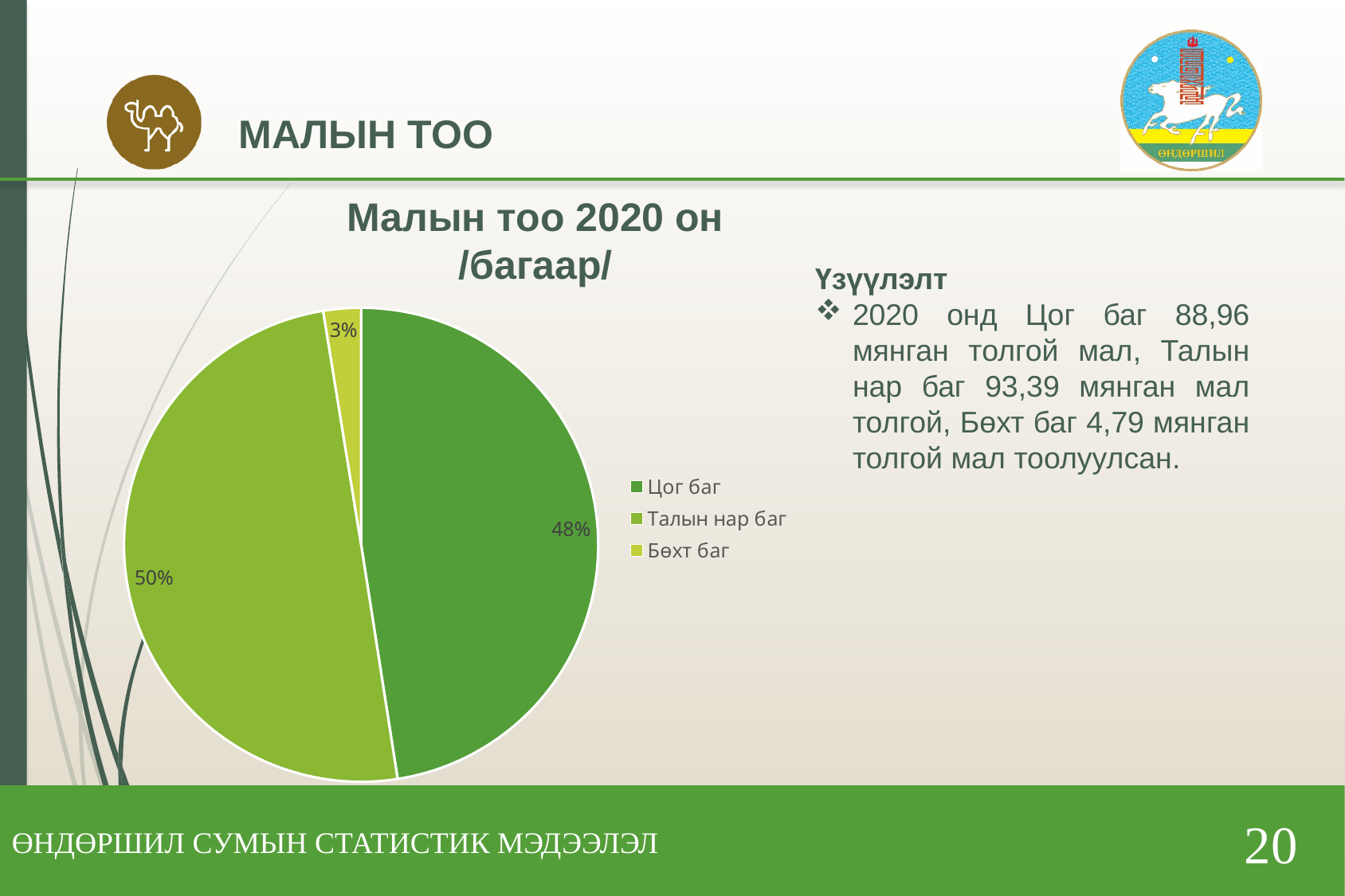
What share of the pie does Цог баг hold? 48% What type of chart is shown on the slide? pie chart How many slices does the pie chart have? 3 What is the difference in percentage points between the shares of Талын нар баг and Цог баг? 2 percentage points What share of the pie does Талын нар баг hold? 50% What is the title of the chart? Малын тоо 2020 он /багаар/ Which is larger, the share of Цог баг or the share of Бөхт баг? Цог баг Which category has the largest slice of the pie? Талын нар баг Which category has the smallest slice of the pie? Бөхт баг Which legend entry is shown in the lightest green colour? Бөхт баг How many entries does the legend list? 3 What share of the pie does Бөхт баг hold? 3%